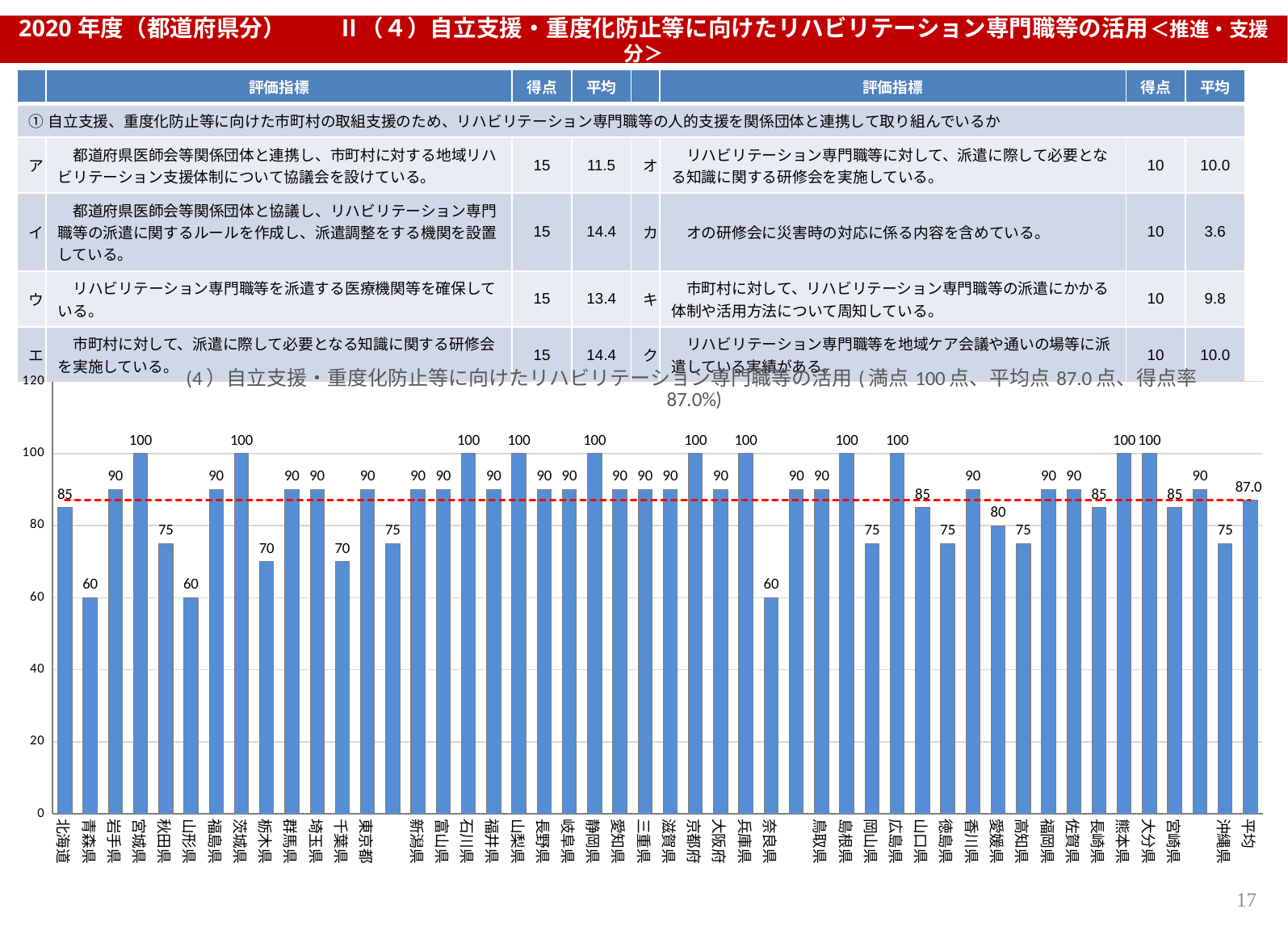
Is the value for 熊本県 greater or less than 80? greater Is the value for 山形県 greater or less than 80? less Which has the larger value, 栃木県 or 群馬県? 群馬県 What is the value for 北海道 in the bar chart? 85 What is the value shown for 平均 (the last bar) in the bar chart? 87.0 What is the value for 奈良県 in the bar chart? 60 What is the difference between the values for 宮城県 and 青森県? 40 What is the value for 青森県 in the bar chart? 60 Which has the larger value, 宮城県 or 秋田県? 宮城県 According to the chart title, what is the 満点 (full score) for this item? 100点 What kind of chart is shown on the slide? bar chart What is the value for 愛媛県 in the bar chart? 80